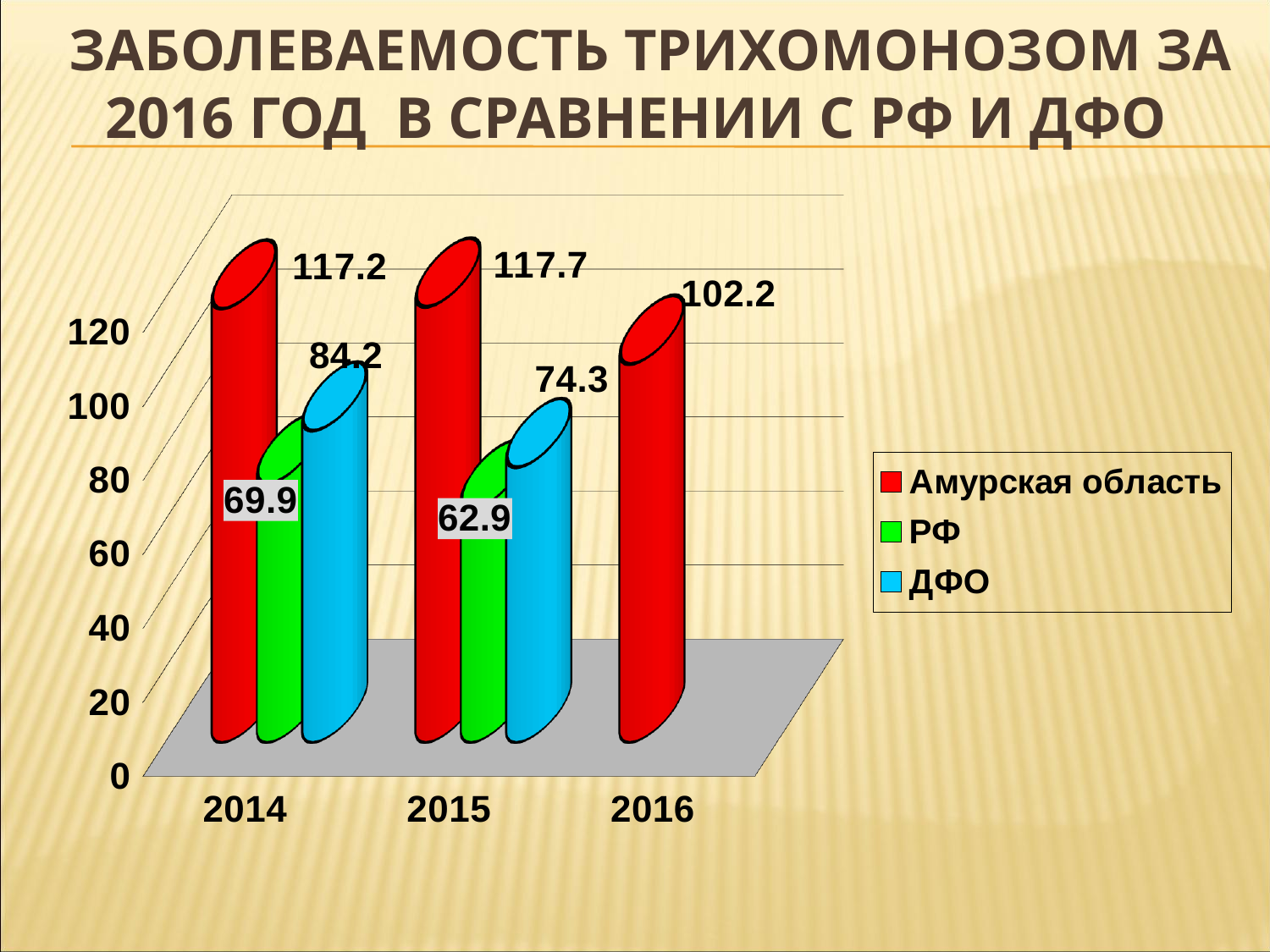
What is the value for Амурская область in 2016? 102.2 What is the value for Амурская область in 2014? 117.2 What is the difference between the Амурская область and РФ values in 2014? 47.3 Does the value for РФ rise or fall from 2014 to 2015? Fall Which is larger in 2015: the value for РФ or the value for ДФО? ДФО In which year is the value for ДФО the highest? 2014 What kind of chart is shown on the slide? Bar chart What is the difference between the ДФО values in 2014 and 2015? 9.9 What is the value for ДФО in 2014? 84.2 How many series does the legend list? 3 What is the value for РФ in 2015? 62.9 In which year is the value for Амурская область the lowest? 2016